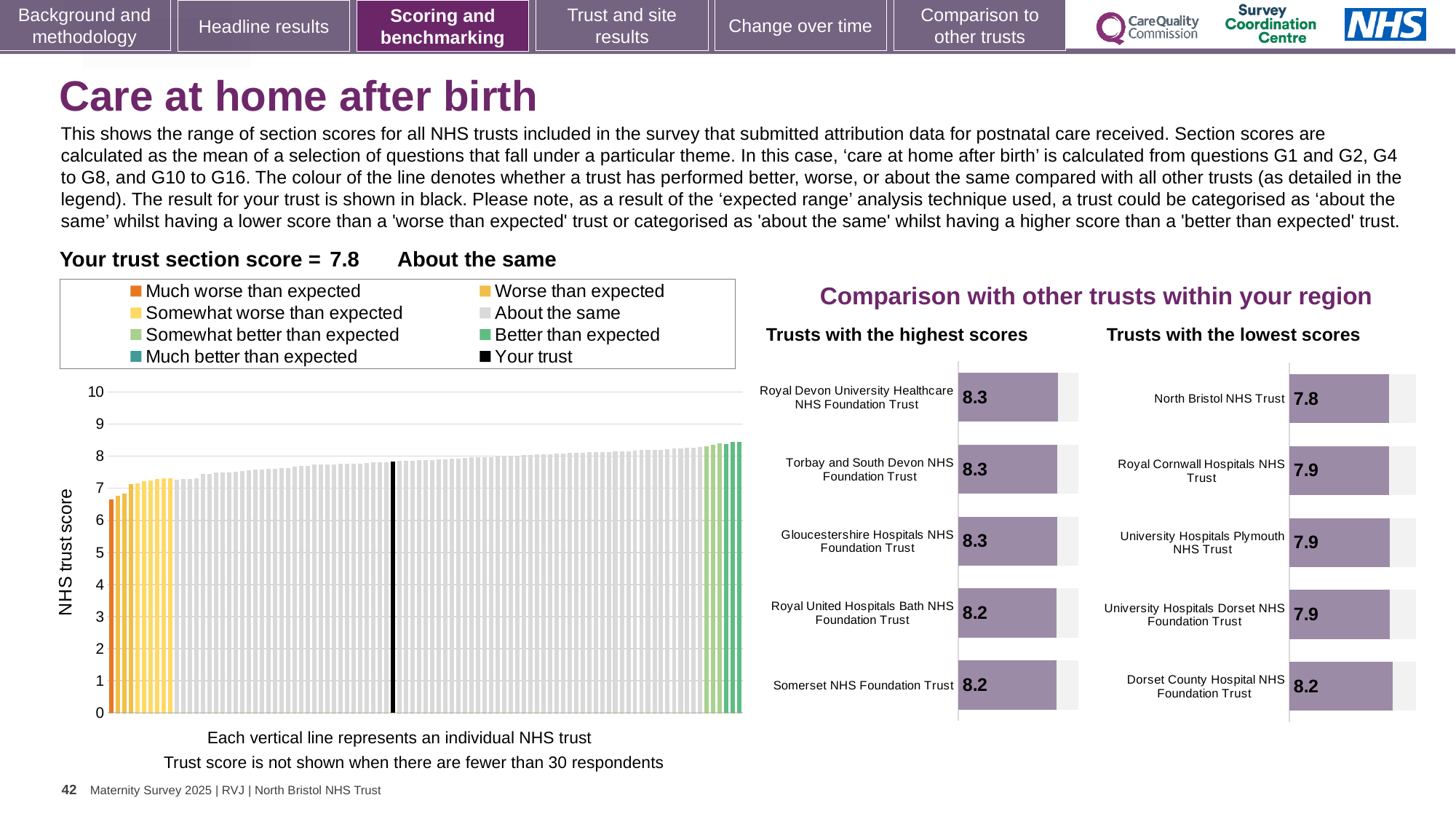
In the main 'NHS trust score' chart, do the bar values rise or fall from left to right? Rise In the 'Trusts with the lowest scores' chart, which trust has the lowest score? North Bristol NHS Trust In the 'Trusts with the lowest scores' chart, which trust has the highest score? Dorset County Hospital NHS Foundation Trust In the 'Trusts with the highest scores' chart, what is the score for Royal Devon University Healthcare NHS Foundation Trust? 8.3 How many entries does the legend of the main 'NHS trust score' chart list? 8 How many trusts are shown in the 'Trusts with the highest scores' chart? 5 What kind of chart is the main chart on the left showing NHS trust scores? Bar chart In the 'Trusts with the highest scores' chart, what is the score for Somerset NHS Foundation Trust? 8.2 In the 'Trusts with the highest scores' chart, which has the larger score: Royal Devon University Healthcare NHS Foundation Trust or Somerset NHS Foundation Trust? Royal Devon University Healthcare NHS Foundation Trust In the main 'NHS trust score' chart, is the value for your trust (the black bar) greater or less than 7? greater In the 'Trusts with the lowest scores' chart, what is the score for North Bristol NHS Trust? 7.8 In the 'Trusts with the lowest scores' chart, what is the difference between the scores of Dorset County Hospital NHS Foundation Trust and North Bristol NHS Trust? 0.4